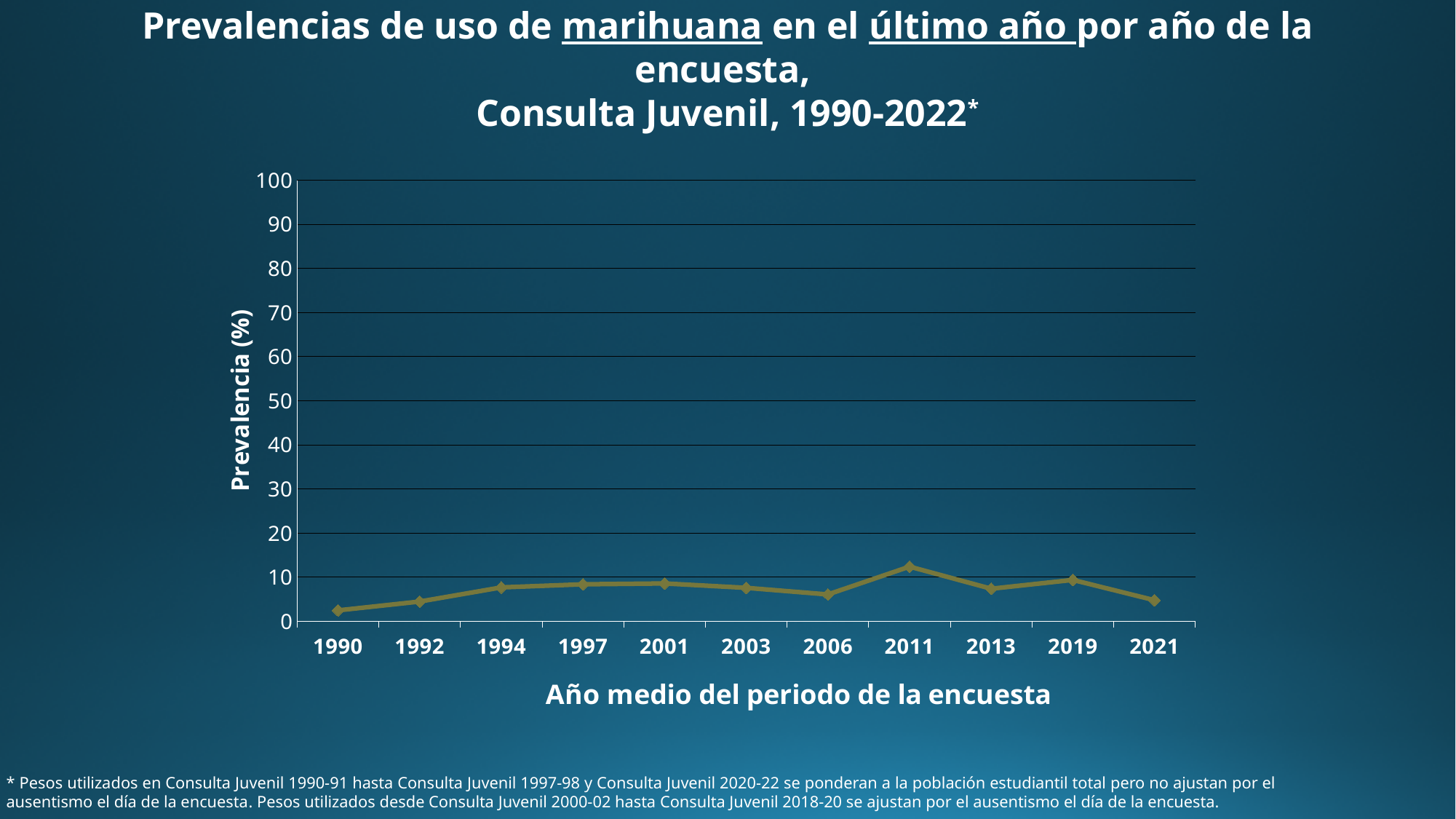
Does the prevalence rise or fall from 2019 to 2021? fall Which has the higher prevalence, 1990 or 2021? 2021 Is the value for 2011 greater or less than 10? greater What is the label of the y axis? Prevalencia (%) What kind of chart is shown on the slide? line chart Is the value for 1990 greater or less than 10? less Which survey year has the lowest prevalence of marijuana use in the last year? 1990 Which has the higher prevalence, 2011 or 2013? 2011 Does the prevalence rise or fall from 1990 to 1994? rise Is the value for 2006 greater or less than 10? less How many survey years are plotted along the x axis? 11 Which survey year has the highest prevalence of marijuana use in the last year? 2011